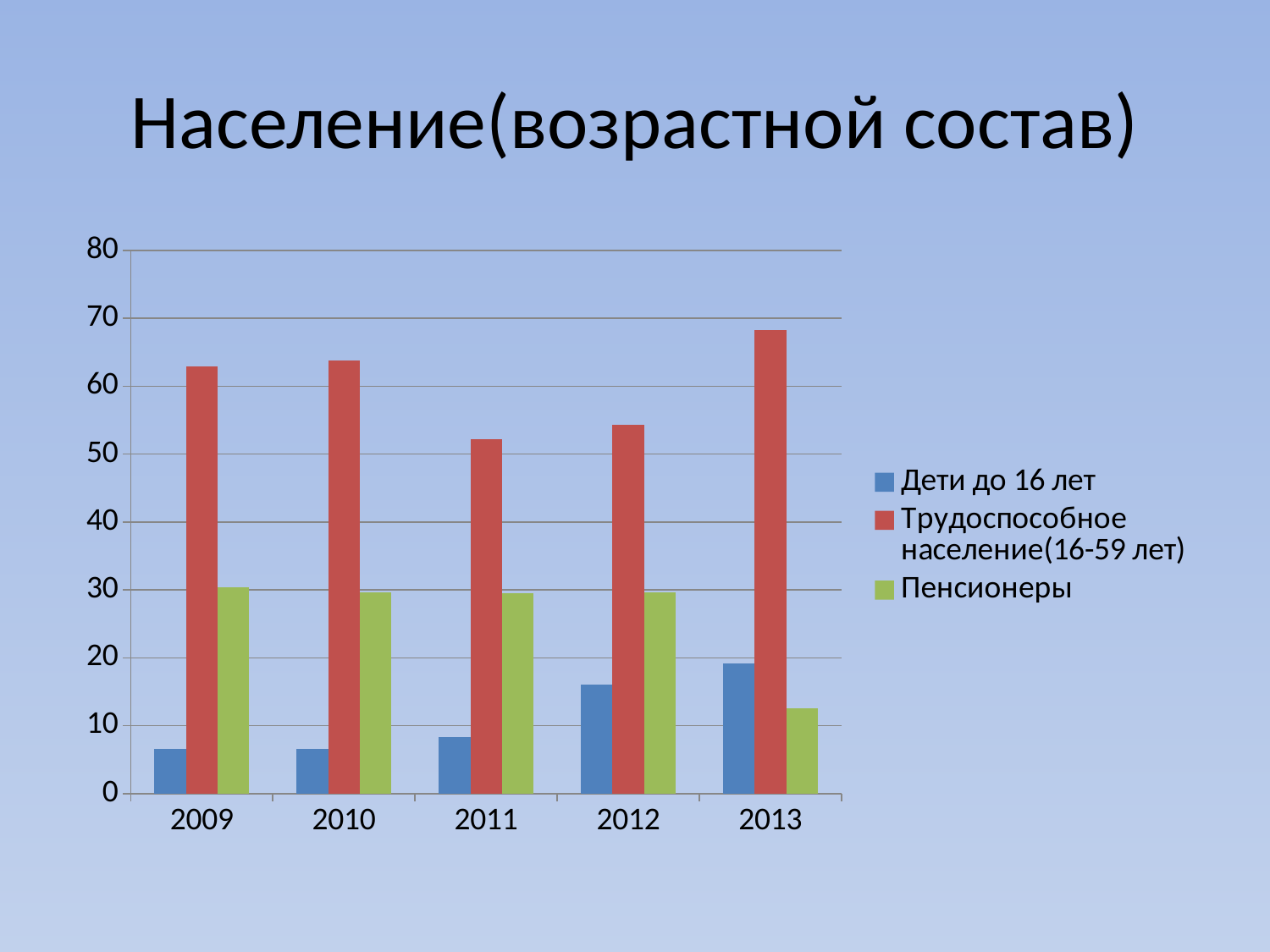
Is the value for Трудоспособное население(16-59 лет) in 2013 greater or less than 60? greater How many series does the legend list? 3 In 2012, which is larger: Дети до 16 лет or Пенсионеры? Пенсионеры Is the value for Пенсионеры in 2013 greater or less than 20? less In which year is the value for Пенсионеры lowest? 2013 Do the values for Дети до 16 лет rise or fall from 2009 to 2013? rise In which year is the value for Дети до 16 лет highest? 2013 In which year is the value for Трудоспособное население(16-59 лет) highest? 2013 What is the title of the slide? Население(возрастной состав) In which year is the value for Трудоспособное население(16-59 лет) lowest? 2011 What kind of chart is shown on the slide? bar chart How many years are shown on the x axis of the chart? 5